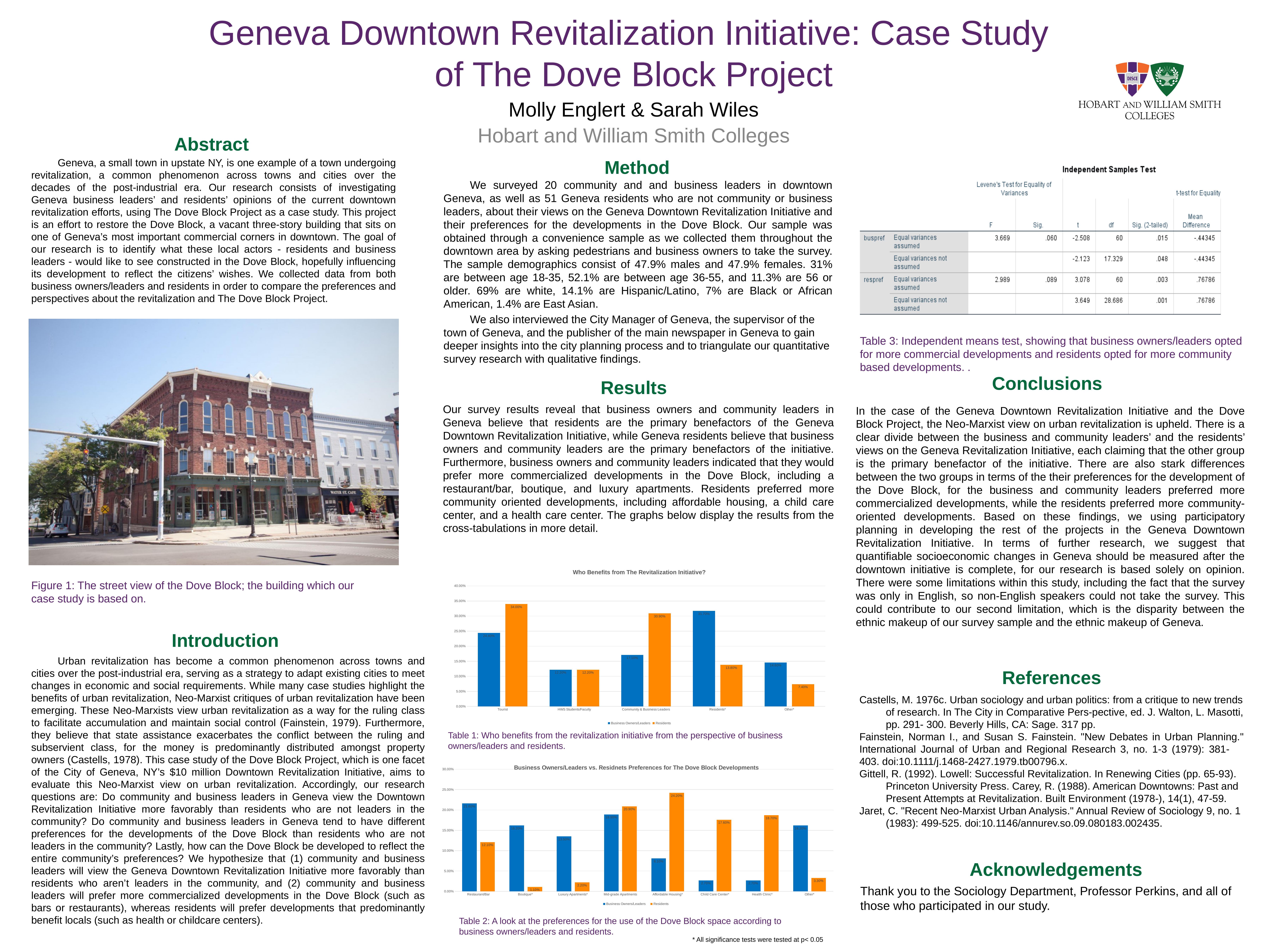
In the chart "Who Benefits from The Revitalization Initiative?", what is the Residents value for Tourist? 34.00% What kind of chart is the chart titled "Who Benefits from The Revitalization Initiative?"? bar chart In the chart "Who Benefits from The Revitalization Initiative?", for the Residents* category, which series has the larger value: Business Owners/Leaders or Residents? Business Owners/Leaders In the chart "Who Benefits from The Revitalization Initiative?", how many series does the legend list? 2 In the chart "Who Benefits from The Revitalization Initiative?", what is the difference between the Residents values for Tourist and Other*? 26.60% In the chart "Business Owners/Leaders vs. Residnets Preferences for The Dove Block Developments", which colour represents the Residents series? orange In the chart "Who Benefits from The Revitalization Initiative?", how many categories are shown on the x axis? 5 In the chart "Who Benefits from The Revitalization Initiative?", which category has the highest Residents value? Tourist In the chart "Business Owners/Leaders vs. Residnets Preferences for The Dove Block Developments", what is the Residents value for Affordable Housing*? 24.20% In the chart "Business Owners/Leaders vs. Residnets Preferences for The Dove Block Developments", which category has the lowest Residents value? Boutique* In the chart "Business Owners/Leaders vs. Residnets Preferences for The Dove Block Developments", how many categories are shown on the x axis? 8 In the chart "Business Owners/Leaders vs. Residnets Preferences for The Dove Block Developments", is the Business Owners/Leaders value for Child Care Center* greater or less than 5.00%? less